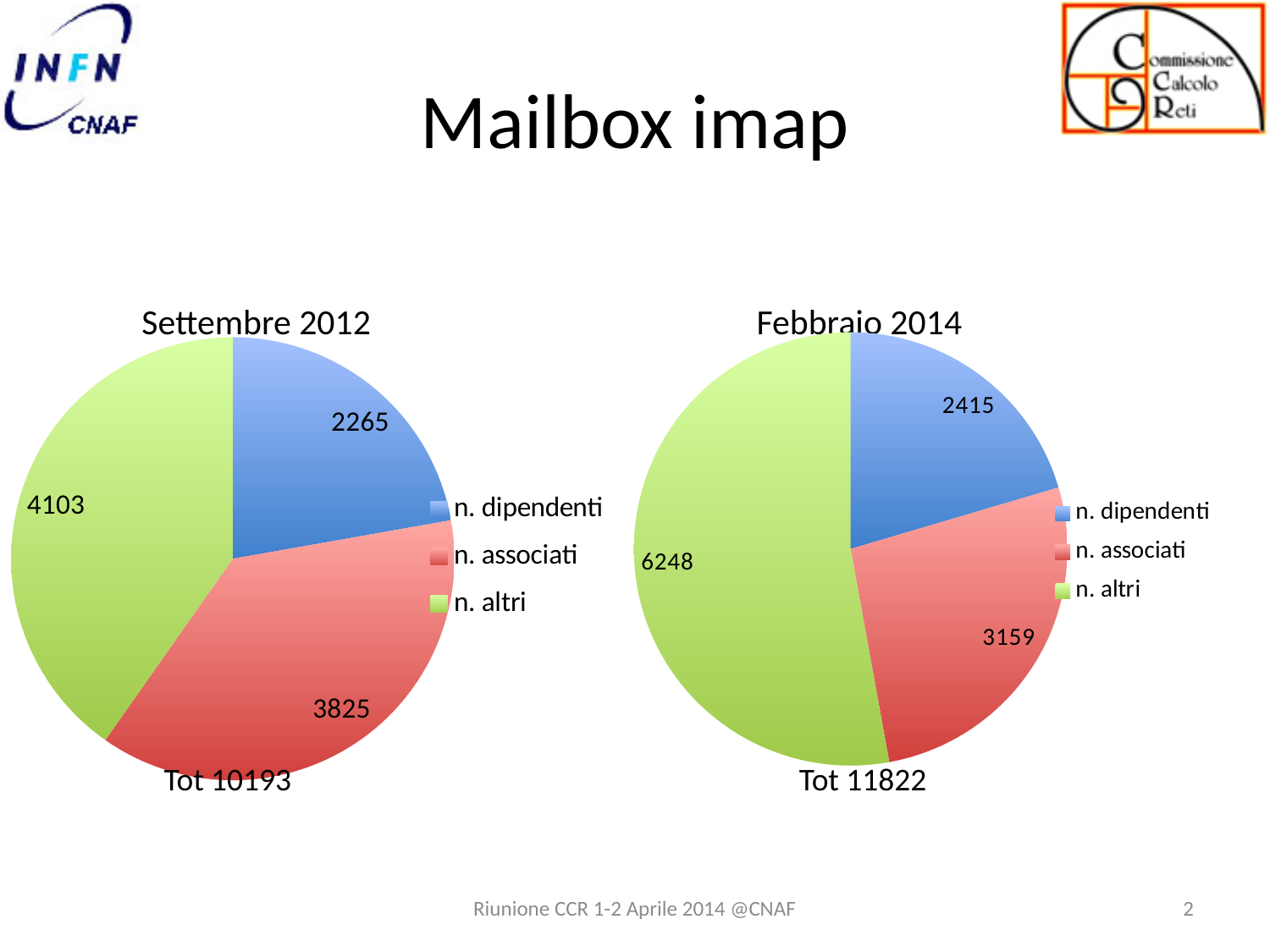
In the Settembre 2012 chart, what is the value for n. associati? 3825 What is the total shown for the Febbraio 2014 chart? Tot 11822 How many slices does the Settembre 2012 pie chart have? 3 In the Febbraio 2014 chart, which category has the largest slice? n. altri Is n. associati larger in the Settembre 2012 chart or in the Febbraio 2014 chart? Settembre 2012 What is the difference between n. dipendenti in Febbraio 2014 and n. dipendenti in Settembre 2012? 150 In the Febbraio 2014 chart, what is the value for n. altri? 6248 In the Febbraio 2014 chart, what is the difference between n. altri and n. associati? 3089 In the Febbraio 2014 chart, which colour represents n. associati? red In the Settembre 2012 chart, which category has the smallest slice? n. dipendenti In the Settembre 2012 chart, what is the value for n. dipendenti? 2265 What kind of chart is used for Settembre 2012? pie chart